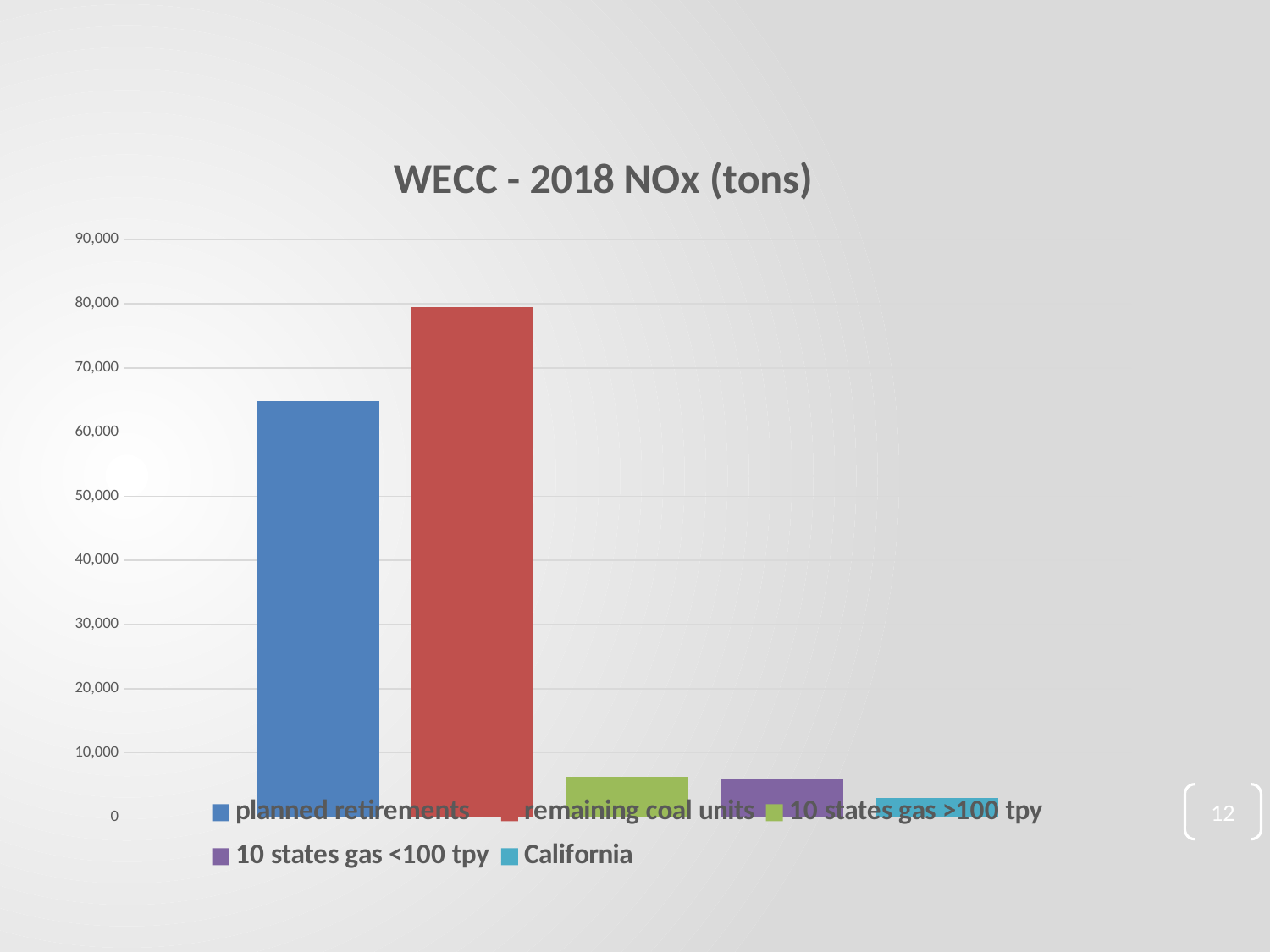
How many series does the legend list? 5 How many bars are plotted in the chart? 5 Is the value for 10 states gas >100 tpy greater or less than 10,000? less Is the value for California greater or less than 10,000? less Which series has the highest value? remaining coal units Which series has the lowest value? California Is the value for remaining coal units greater or less than 70,000? greater What type of chart is shown on the slide? bar chart Which is larger, California or planned retirements? planned retirements Which is larger, planned retirements or remaining coal units? remaining coal units What is the title of the chart? WECC - 2018 NOx (tons)